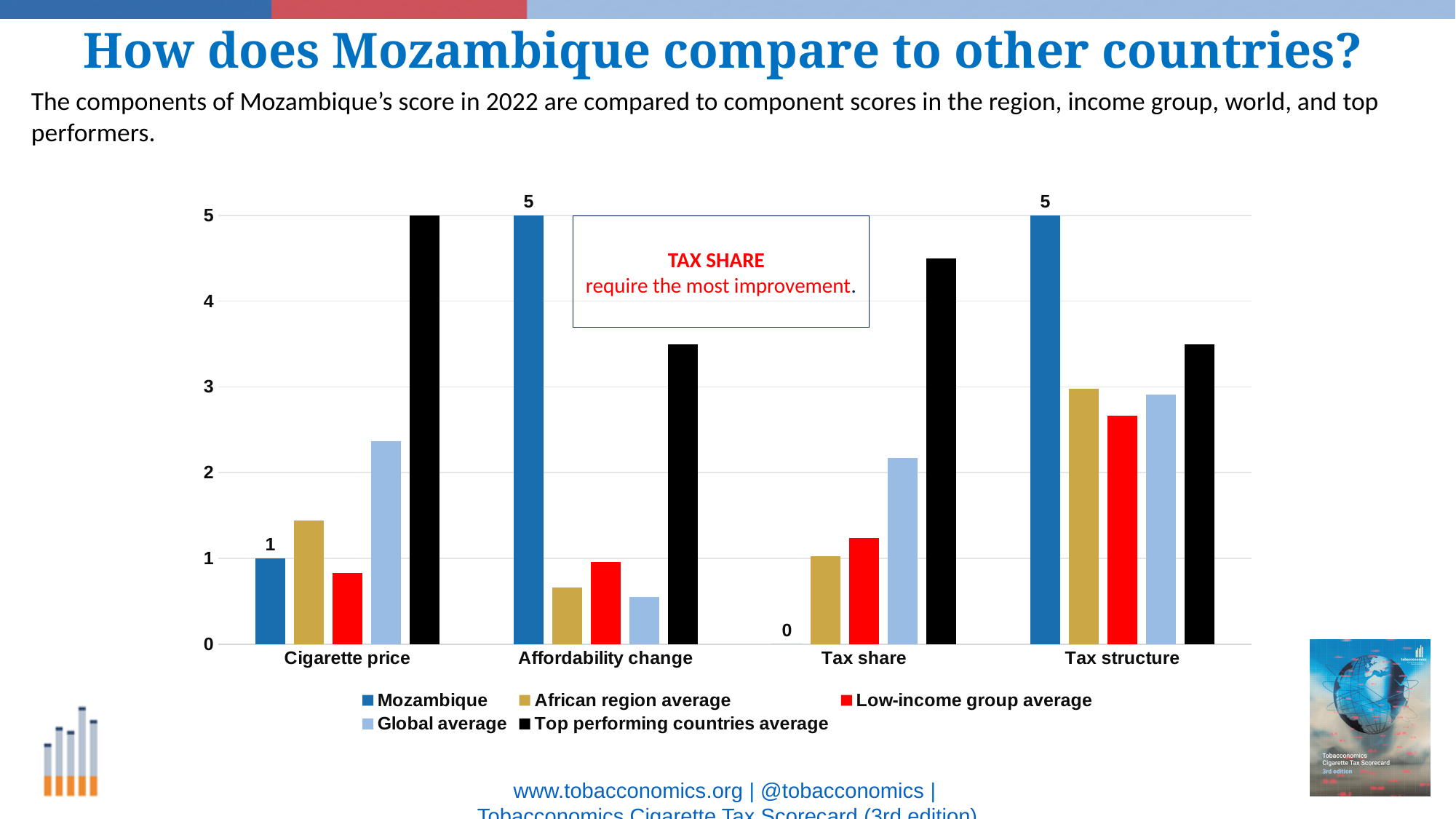
In which component does Mozambique have its lowest score? Tax share What is Mozambique's score for Tax structure? 5 For Tax structure, which is larger: the African region average or the Low-income group average? African region average What is Mozambique's score for Affordability change? 5 How many series does the legend list? 5 What is the difference between Mozambique's Affordability change score and its Cigarette price score? 4 Is the Global average for Cigarette price greater or less than 2? greater What is Mozambique's score for Tax share? 0 Is the Top performing countries average for Tax share greater or less than 4? greater How many component categories are shown on the x axis? 4 What is Mozambique's score for Cigarette price? 1 What kind of chart is shown on the slide? Bar chart